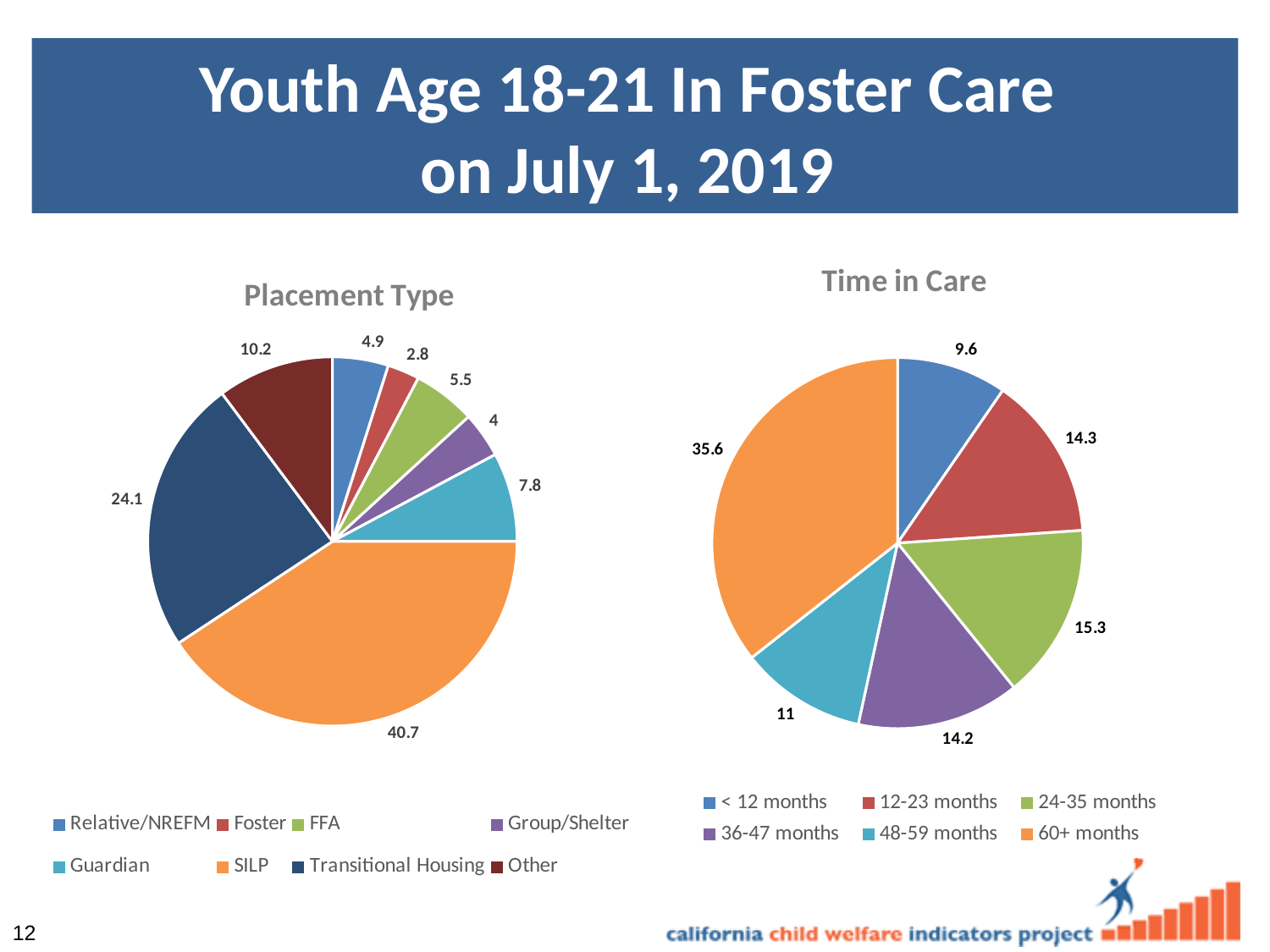
In the Placement Type chart, what is the value for Transitional Housing? 24.1 In the Placement Type chart, which placement type has the largest slice? SILP In the Time in Care chart, which is larger, 24-35 months or 36-47 months? 24-35 months In the Placement Type chart, which placement type has the smallest slice? Foster In the Time in Care chart, which category has the smallest slice? < 12 months In the Placement Type chart, how many placement types are shown? 8 In the Placement Type chart, what is the difference between the values for SILP and Transitional Housing? 16.6 In the Time in Care chart, what is the value for 60+ months? 35.6 In the Time in Care chart, what is the value for 48-59 months? 11 In the Placement Type chart, what is the value for SILP? 40.7 What type of chart is the Time in Care chart? Pie chart In the Time in Care chart, how many categories does the legend list? 6